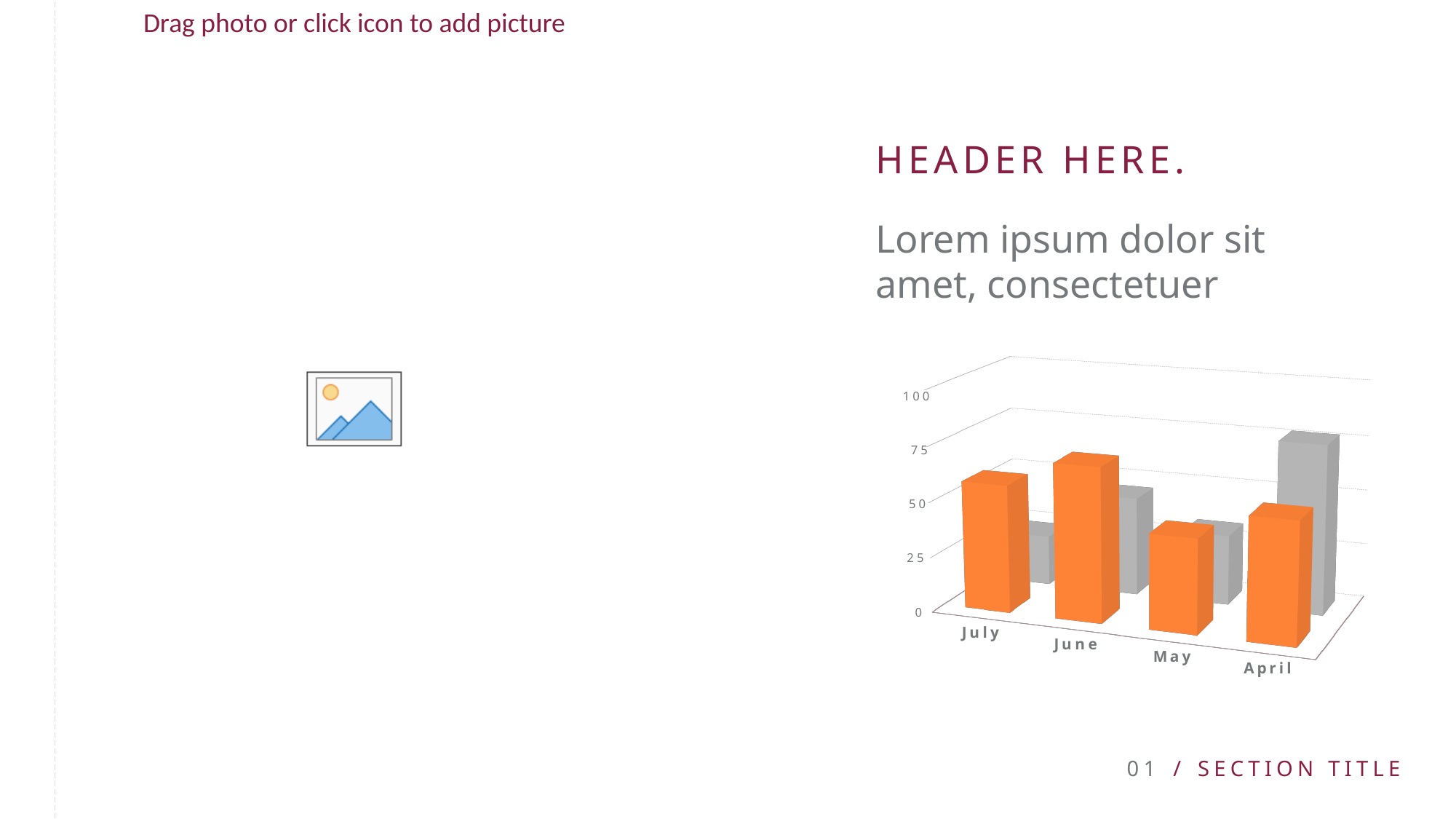
What kind of chart is shown on the slide? bar chart Is the orange bar for June greater or less than 50? greater Which is larger, the orange bar for June or the orange bar for May? June Which months are labelled on the x axis of the chart, from left to right? July, June, May, April Which month has the tallest orange bar? June Is the gray bar for April greater or less than 50? greater How many categories are shown on the x axis of the chart? 4 How many bars are plotted for each month in the chart? 2 Is the gray bar for July greater or less than 50? less What two colours are used for the bars in the chart? orange and gray Which month has the shortest orange bar? May Which month has the tallest gray bar? April